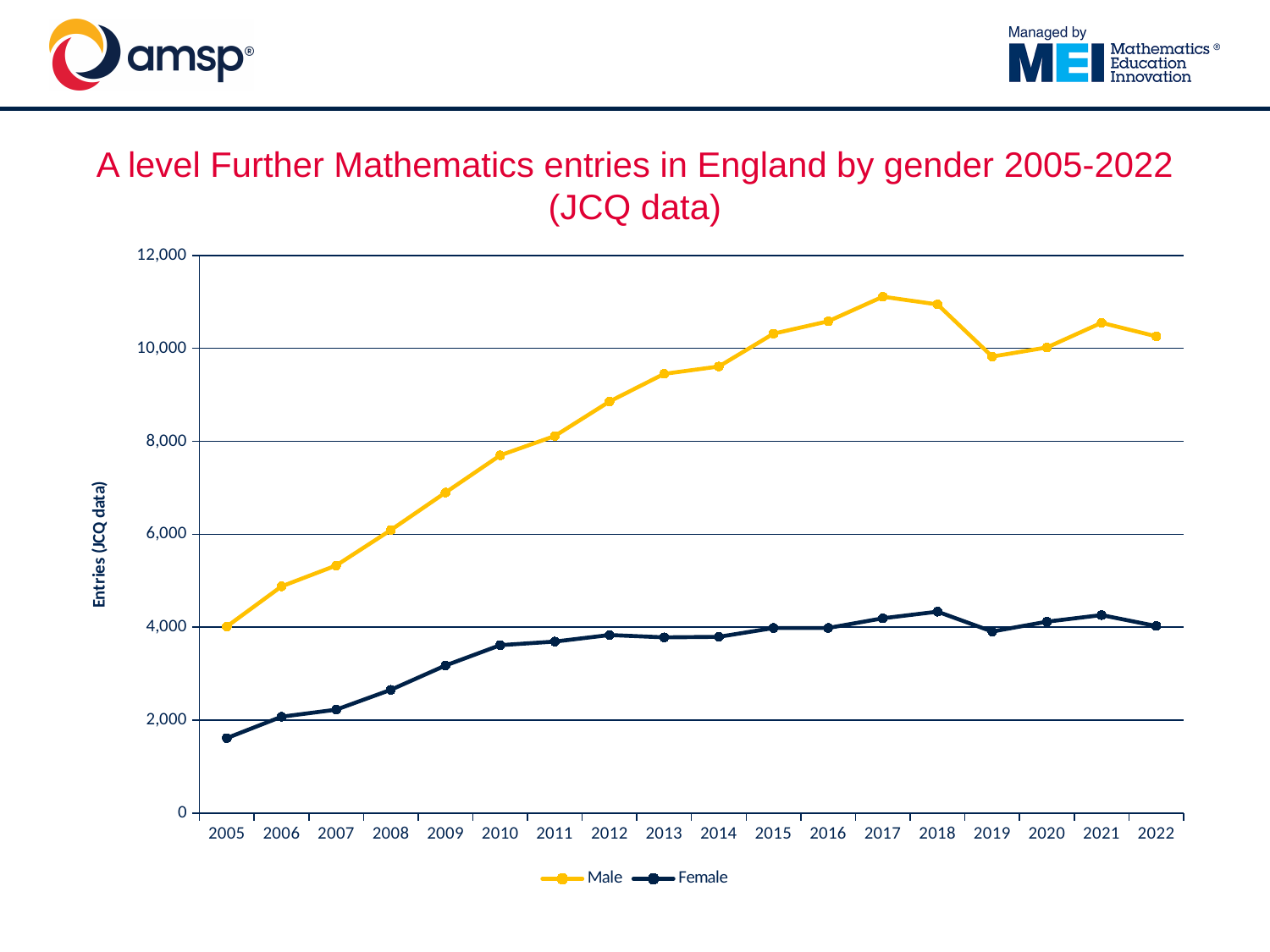
What kind of chart is shown on the slide? line chart Which colour is used for the Male series? yellow Does the Male series generally rise or fall between 2005 and 2017? rise Is the value for Female in 2009 greater or less than 4,000? less In 2010, which series has the larger value, Male or Female? Male In which year is the Male series at its lowest value? 2005 How many series does the legend list? 2 Is the value for Male in 2010 greater or less than 8,000? less How many years are plotted along the x axis? 18 In which year does the Male series reach its highest value? 2017 Is the value for Male in 2016 greater or less than 10,000? greater In which year is the Female series at its lowest value? 2005